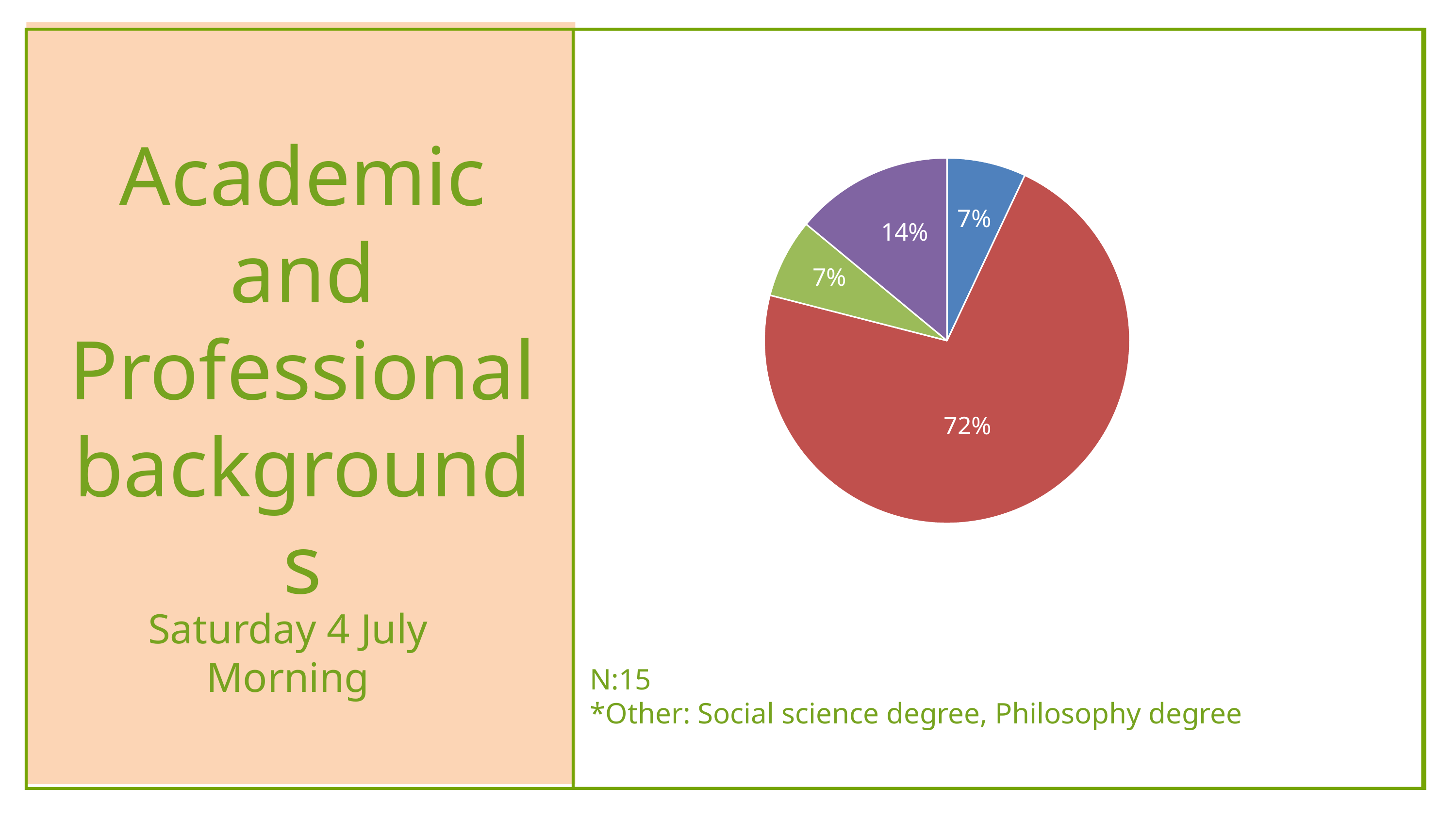
Which colour slice is the largest in the pie chart? red What is the difference in percentage points between the purple slice and the green slice? 7 Which slice is larger in the pie chart, the purple slice or the blue slice? purple What percentage is shown on the blue slice of the pie chart? 7% What percentage is shown on the purple slice of the pie chart? 14% What kind of chart is shown on the slide? pie chart What sample size (N) is stated below the pie chart? N:15 According to the note below the chart, what does 'Other' include? Social science degree, Philosophy degree What percentage is shown on the green slice of the pie chart? 7% How many slices does the pie chart have? 4 What is the difference in percentage points between the red slice and the purple slice? 58 What percentage is shown on the red slice of the pie chart? 72%